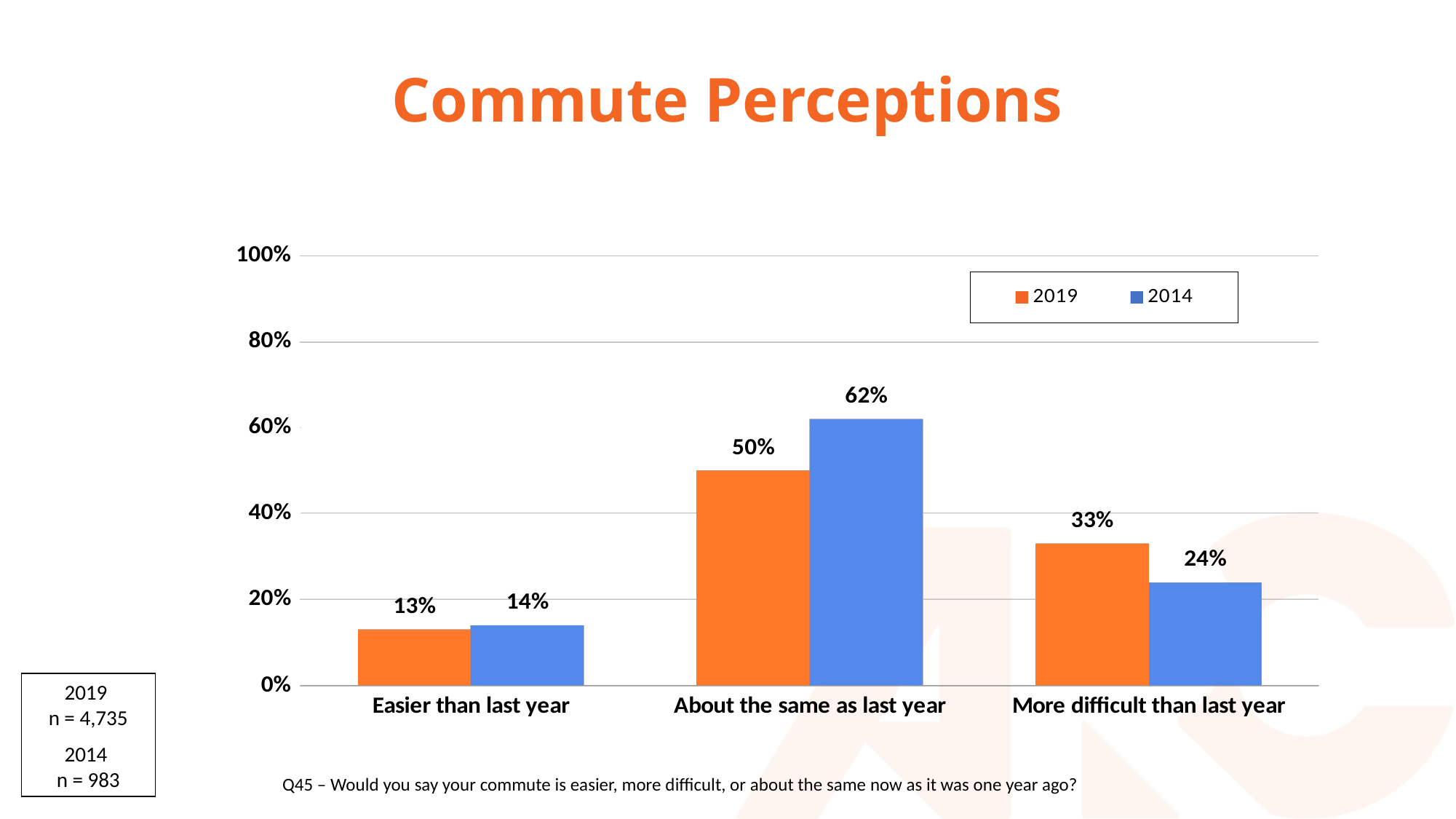
For 'More difficult than last year', which series has the larger value, 2019 or 2014? 2019 How many series does the legend list? 2 What percentage of 2019 respondents said their commute was about the same as last year? 50% What is the 2014 value for 'Easier than last year'? 14% What type of chart is shown on the slide? Bar chart How many categories are shown on the x axis? 3 What percentage of 2014 respondents said their commute was more difficult than last year? 24% What is the difference between the 2019 and 2014 values for 'More difficult than last year'? 9% What is the difference between the 2014 and 2019 values for 'About the same as last year'? 12% Is the 2019 value for 'About the same as last year' greater or less than 40%? greater Which category has the lowest value for the 2019 series? Easier than last year Which category has the highest value for the 2014 series? About the same as last year